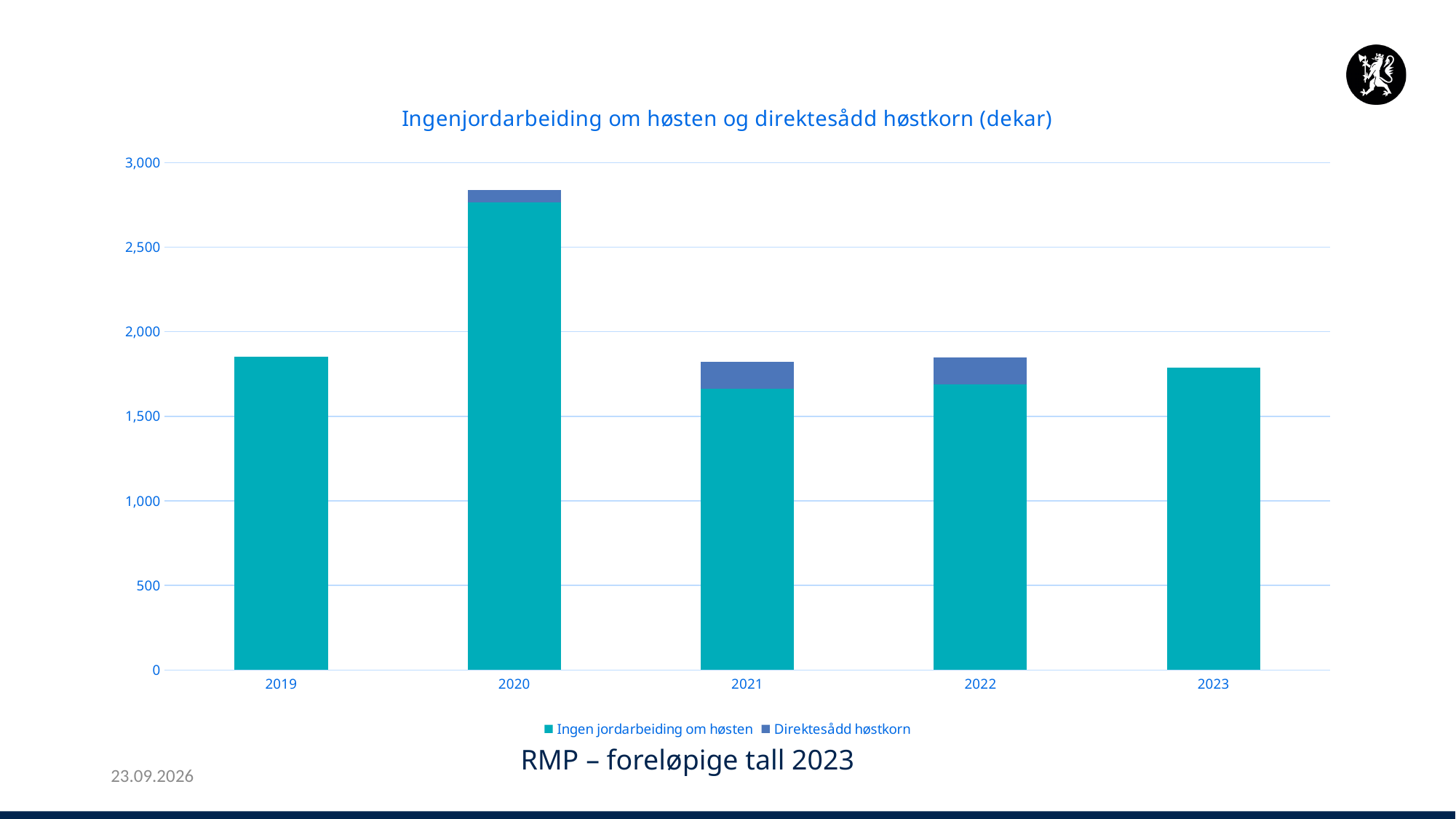
Is the value for 2019 greater or less than 1,500? greater Is the total value for 2020 greater or less than 2,500? greater How many series does the chart's legend list? 2 Does the total value rise or fall from 2020 to 2021? fall Is the 'Ingen jordarbeiding om høsten' value for 2021 greater or less than 2,000? less Which year has the highest total bar in the chart? 2020 Which has the larger total bar, 2020 or 2023? 2020 Which series is shown in teal in the chart's legend? Ingen jordarbeiding om høsten What kind of chart is shown on the slide? Stacked bar chart What is the title of the chart? Ingenjordarbeiding om høsten og direktesådd høstkorn (dekar) How many years are shown on the x axis of the chart? 5